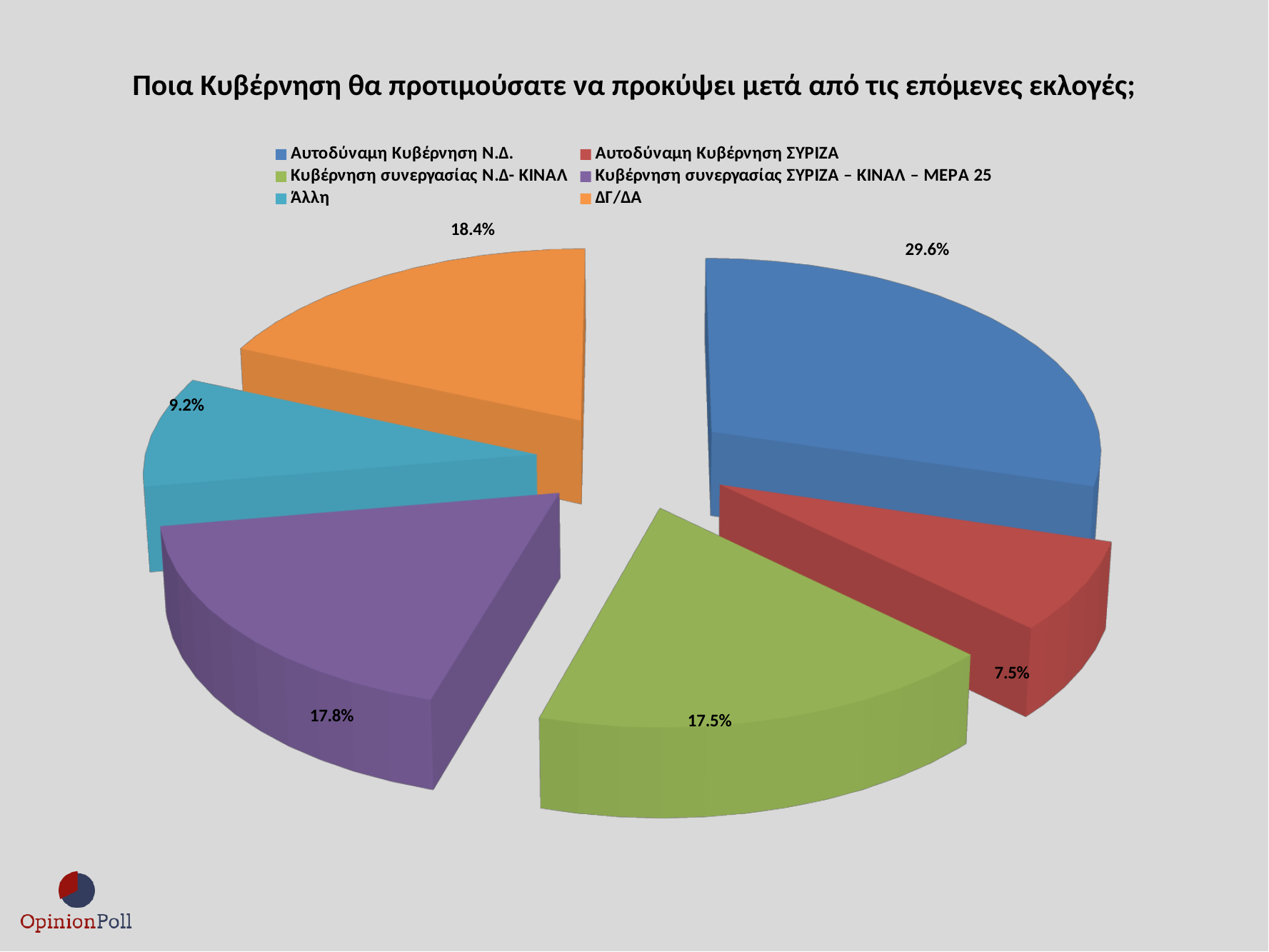
How many slices does the pie chart have? 6 What percentage is shown for Κυβέρνηση συνεργασίας Ν.Δ- ΚΙΝΑΛ? 17.5% Which category has the smallest slice of the pie? Αυτοδύναμη Κυβέρνηση ΣΥΡΙΖΑ What percentage is shown for ΔΓ/ΔΑ? 18.4% What kind of chart is shown on the slide? Pie chart Which is larger, the slice for ΔΓ/ΔΑ or the slice for Άλλη? ΔΓ/ΔΑ What percentage is shown for Αυτοδύναμη Κυβέρνηση Ν.Δ.? 29.6% What colour is the slice for Άλλη? Light blue What percentage is shown for Κυβέρνηση συνεργασίας ΣΥΡΙΖΑ – ΚΙΝΑΛ – ΜΕΡΑ 25? 17.8% What percentage is shown for Αυτοδύναμη Κυβέρνηση ΣΥΡΙΖΑ? 7.5% Which category has the largest slice of the pie? Αυτοδύναμη Κυβέρνηση Ν.Δ. What is the difference in percentage points between Αυτοδύναμη Κυβέρνηση Ν.Δ. and Αυτοδύναμη Κυβέρνηση ΣΥΡΙΖΑ? 22.1